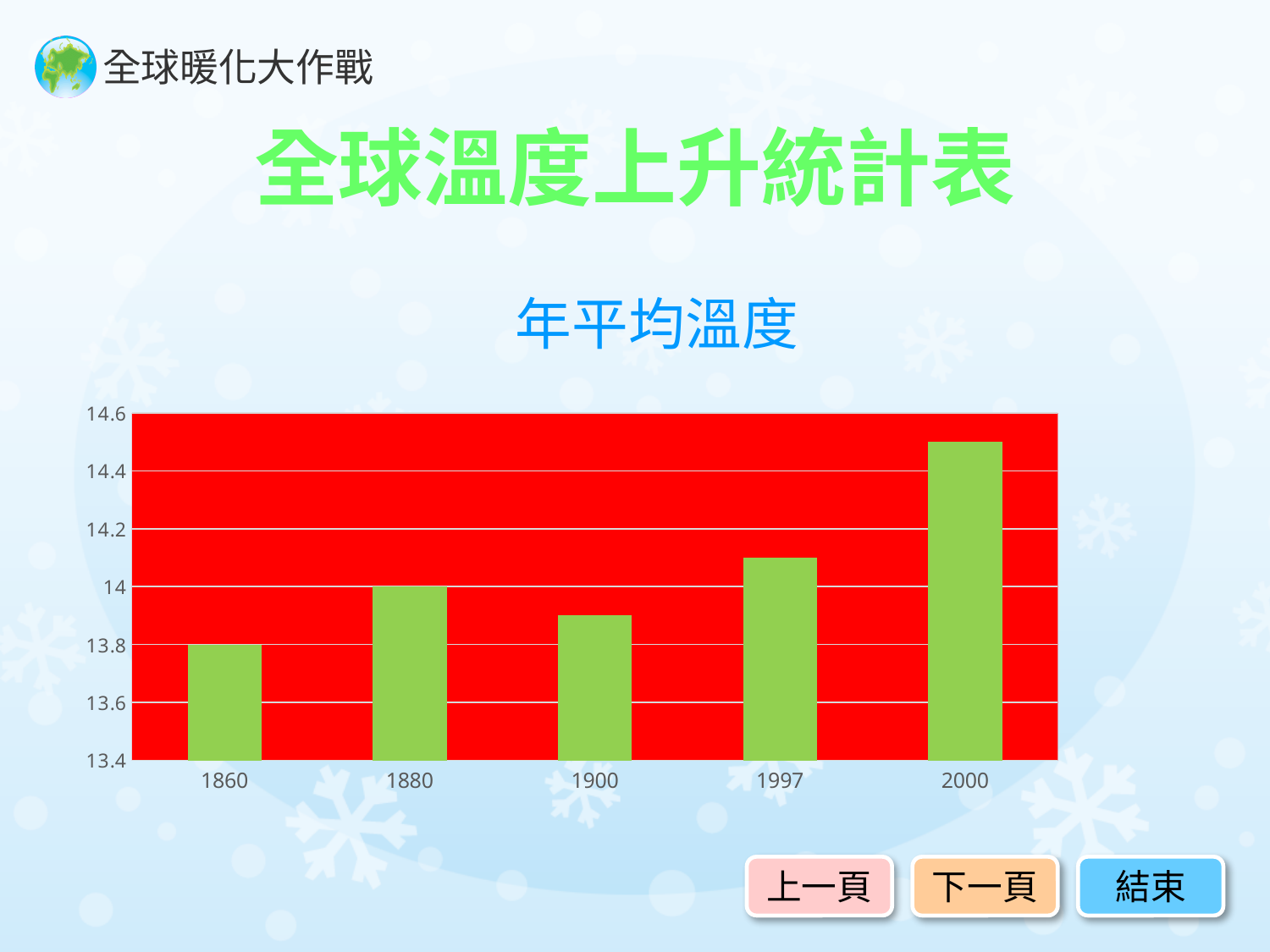
How many years (categories) are shown on the x axis of the chart? 5 What colour are the bars in the chart? green What is the value for 1880 in the chart? 14 Is the value for 1900 greater or less than 14? less What is the value for 1860 in the chart? 13.8 Which is larger, the value for 1880 or the value for 1900? 1880 What is the title of the chart? 年平均溫度 What kind of chart is shown on the slide? bar chart Is the value for 1997 greater or less than 14.2? less Which year has the highest bar in the chart? 2000 Is the value for 2000 greater or less than 14.4? greater Which year has the lowest bar in the chart? 1860